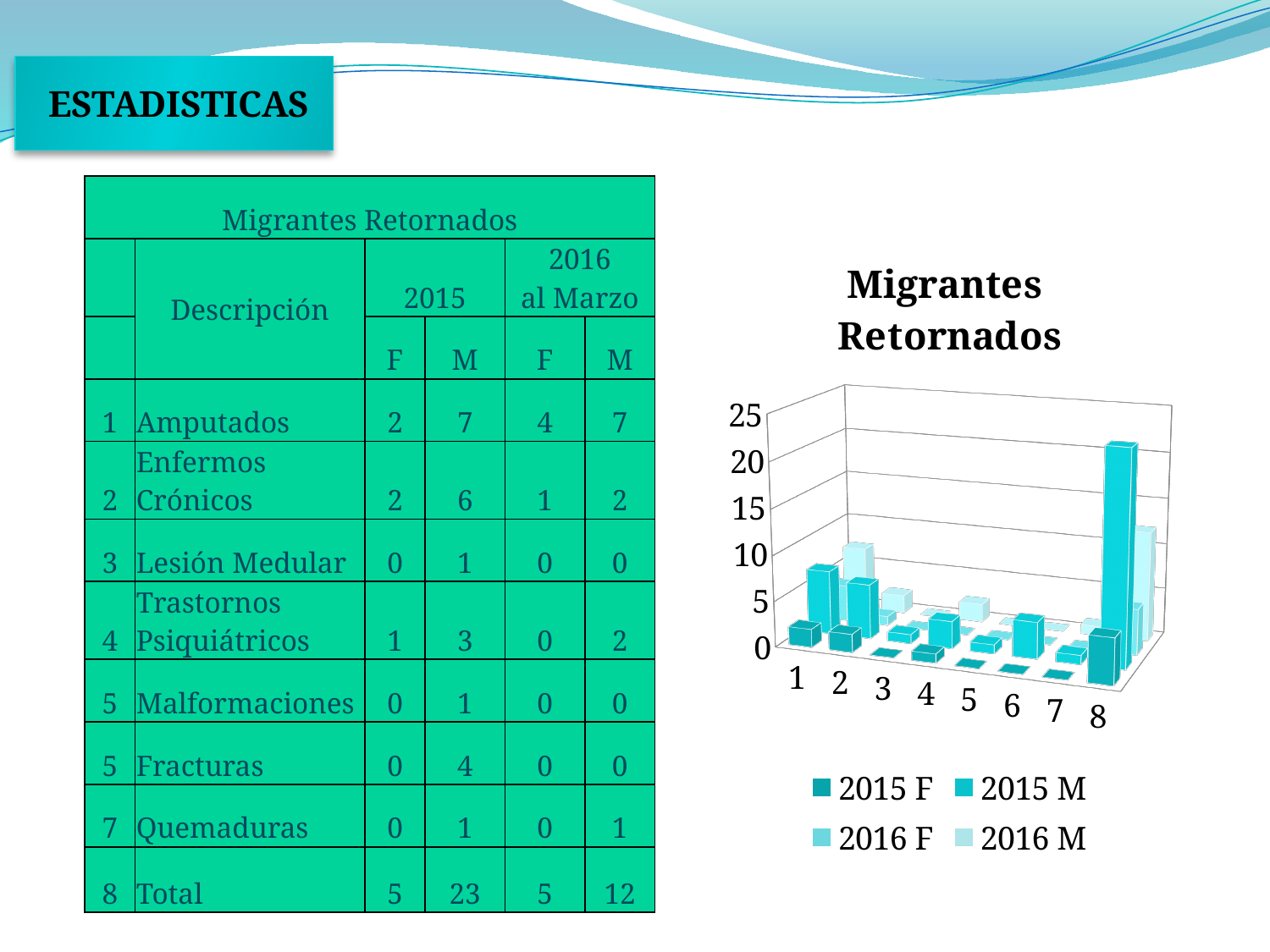
Is the 2016 M value for category 8 greater or less than 10? greater How many categories are shown along the x axis of the chart? 8 What kind of chart is shown on the slide? bar chart What is the title of the chart? Migrantes Retornados Is the 2015 M value for category 8 greater or less than 20? greater Which category has the tallest bar in the chart? 8 Is the 2015 M value for category 1 greater or less than 5? greater Which series has the tallest bar in the chart? 2015 M How many series does the chart legend list? 4 Which series are listed in the chart legend? 2015 F, 2015 M, 2016 F, 2016 M For category 8, which is larger: the 2015 M bar or the 2016 M bar? 2015 M